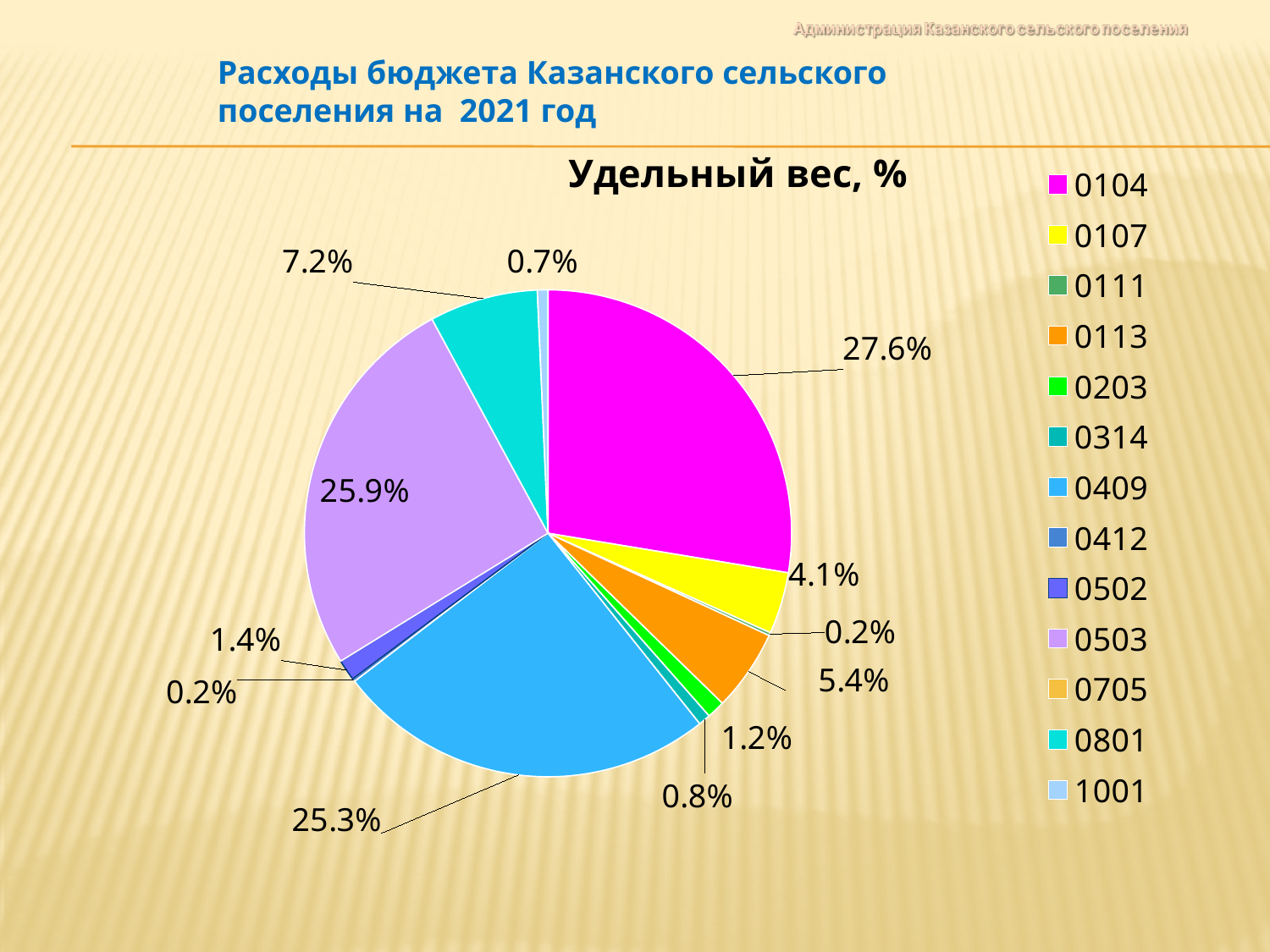
What share of the pie does category 0801 have? 7.2% What is the title of the chart? Удельный вес, % Which category has the largest share of the pie? 0104 What share of the pie does category 0113 have? 5.4% Which has the larger share, category 0503 or category 0409? 0503 What share of the pie does category 0409 have? 25.3% How many entries does the chart legend list? 13 What share of the pie does category 0503 have? 25.9% What share of the pie does category 0104 have? 27.6% What type of chart is shown on the slide? pie chart What is the difference in percentage points between the shares of category 0104 and category 0503? 1.7 What share of the pie does category 0107 have? 4.1%